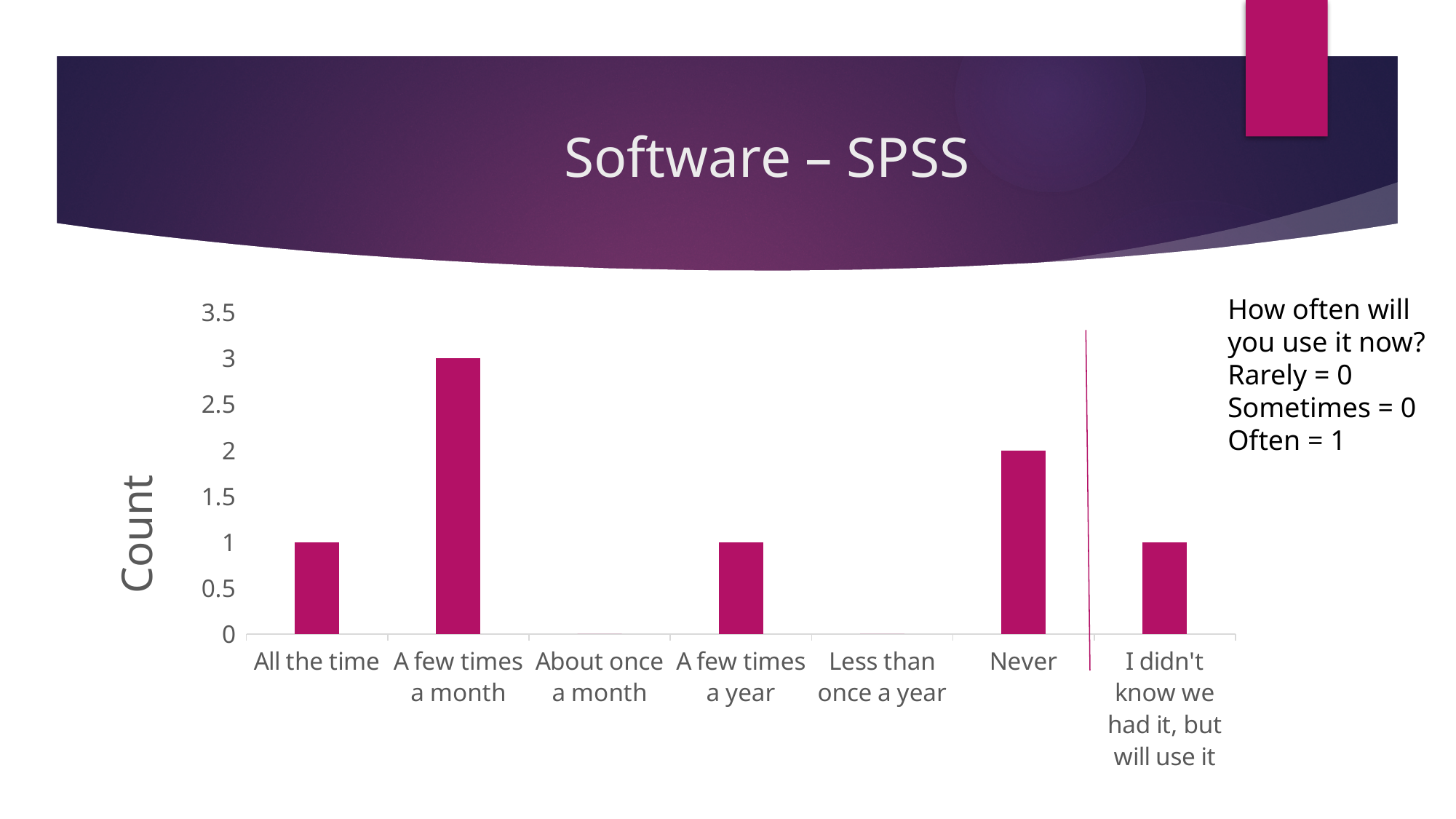
What is the difference between the counts for "Never" and "I didn't know we had it, but will use it"? 1 What is the count for "All the time"? 1 What is the count for "A few times a year"? 1 What is the count for "A few times a month"? 3 Is the count for "A few times a month" greater or less than 2? greater How many categories are shown on the x axis? 7 What is the count for "Never"? 2 What is the label of the vertical axis? Count What is the difference between the counts for "A few times a month" and "Never"? 1 Which has a larger count, "Never" or "All the time"? Never Which category has the highest count? A few times a month What kind of chart is shown on the slide? bar chart